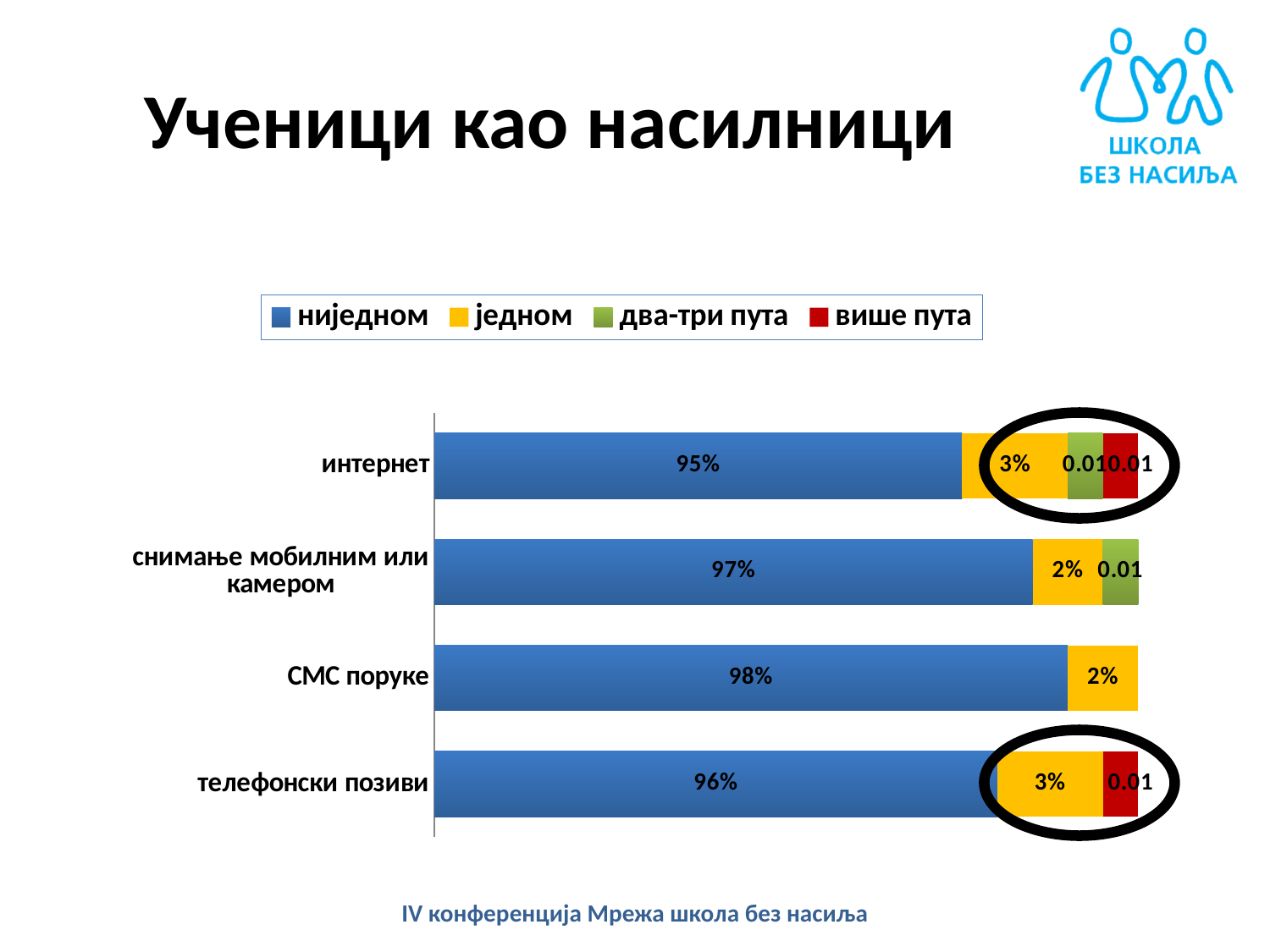
Which is larger, the 'једном' value for 'интернет' or for 'СМС поруке'? интернет Which legend entry is shown in red? више пута What is the difference between the 'ниједном' values for 'СМС поруке' and 'интернет'? 3% How many series does the legend list? 4 What is the value of 'ниједном' for 'СМС поруке'? 98% Which category has the lowest value for 'ниједном'? интернет Which category has the highest value for 'ниједном'? СМС поруке What kind of chart is shown on the slide? stacked bar chart What is the value of 'ниједном' for 'снимање мобилним или камером'? 97% What is the value of 'ниједном' for 'интернет'? 95% How many categories are shown on the chart? 4 What is the value of 'једном' for 'телефонски позиви'? 3%